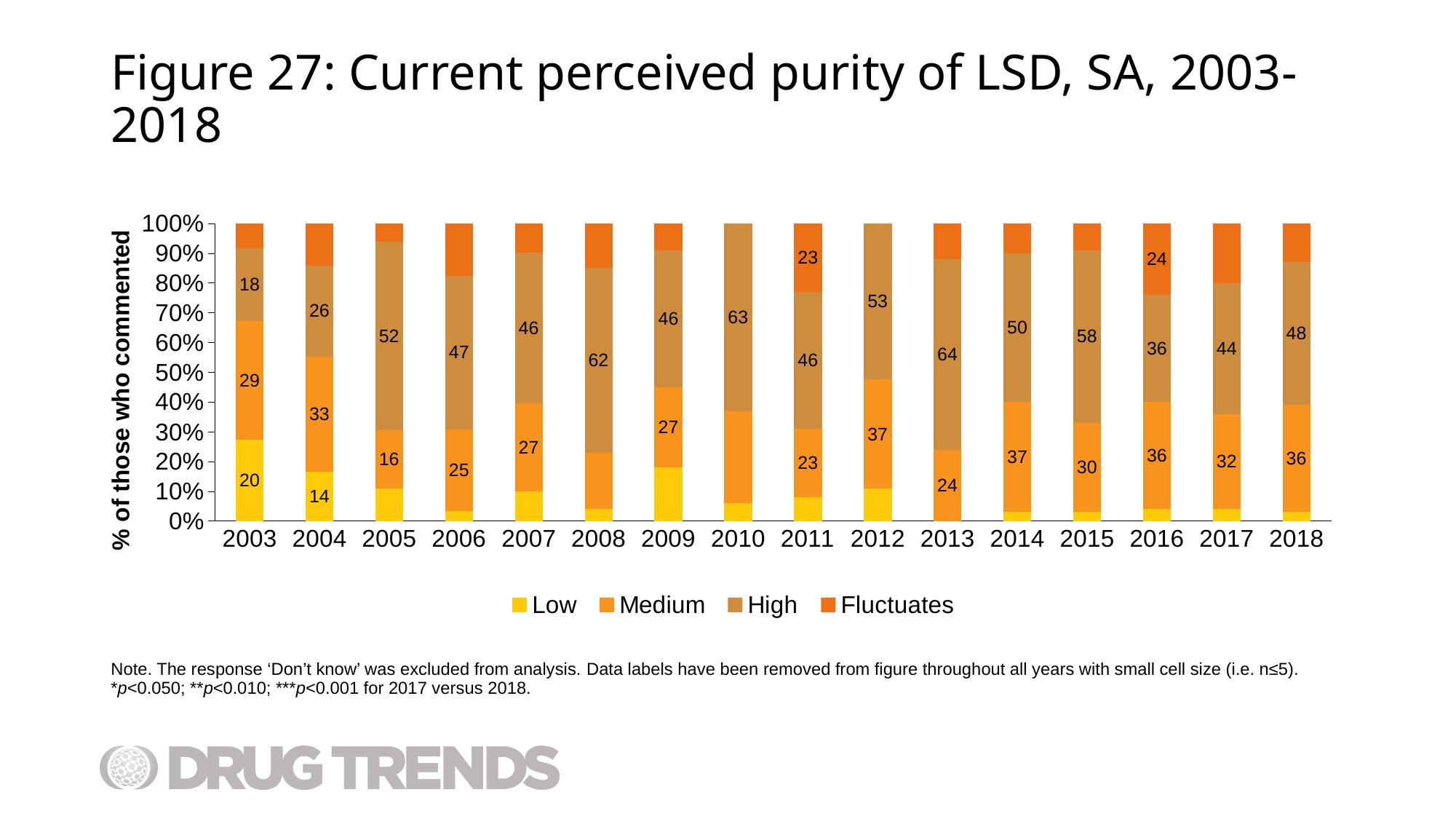
What is the title of the y axis? % of those who commented How many years are shown on the x axis? 16 What is the data label for the Low segment in 2003? 20 What kind of chart is shown on the slide? Stacked bar chart Is the Low segment for 2009 greater or less than 10%? greater Which year has the larger Medium label, 2003 or 2004? 2004 How many series does the legend list? 4 What is the data label for the Fluctuates segment in 2016? 24 What is the difference between the High and Medium labels in 2018? 12 What is the data label for the High segment in 2013? 64 Which year has the highest labelled value for the High segment? 2013 What is the data label for the Medium segment in 2012? 37